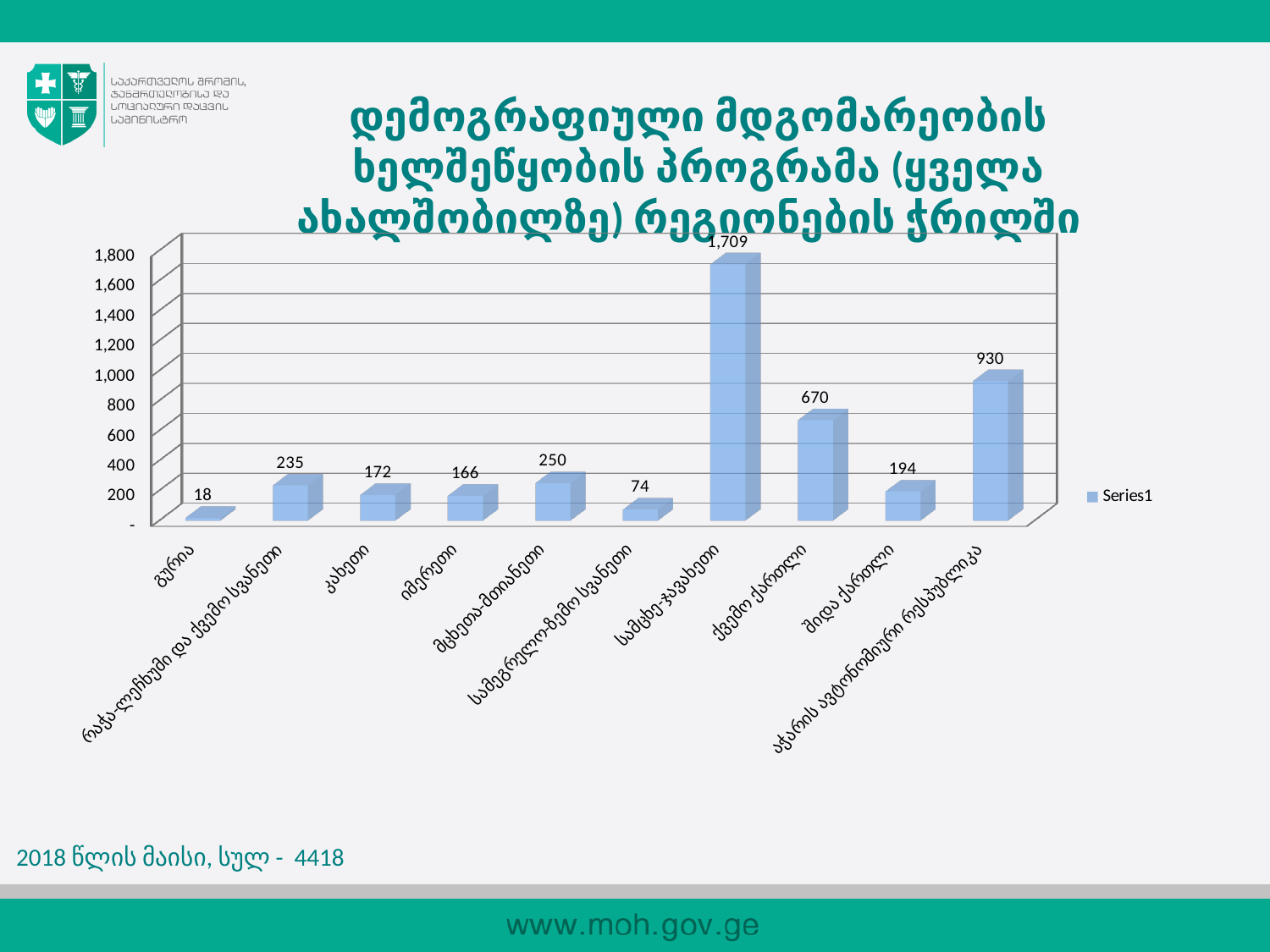
What is the value for აჭარის ავტონომიური რესპუბლიკა? 930 How many regions are shown on the x axis? 10 Which is larger, the value for კახეთი or the value for მცხეთა-მთიანეთი? მცხეთა-მთიანეთი How many series does the legend list? 1 What is the value for გურია? 18 What is the difference between the values for სამცხე-ჯავახეთი and აჭარის ავტონომიური რესპუბლიკა? 779 What kind of chart is shown on the slide? bar chart What is the value for ქვემო ქართლი? 670 What is the value for სამცხე-ჯავახეთი? 1,709 Is the value for ქვემო ქართლი greater or less than 600? greater Which region has the highest value? სამცხე-ჯავახეთი Which region has the lowest value? გურია